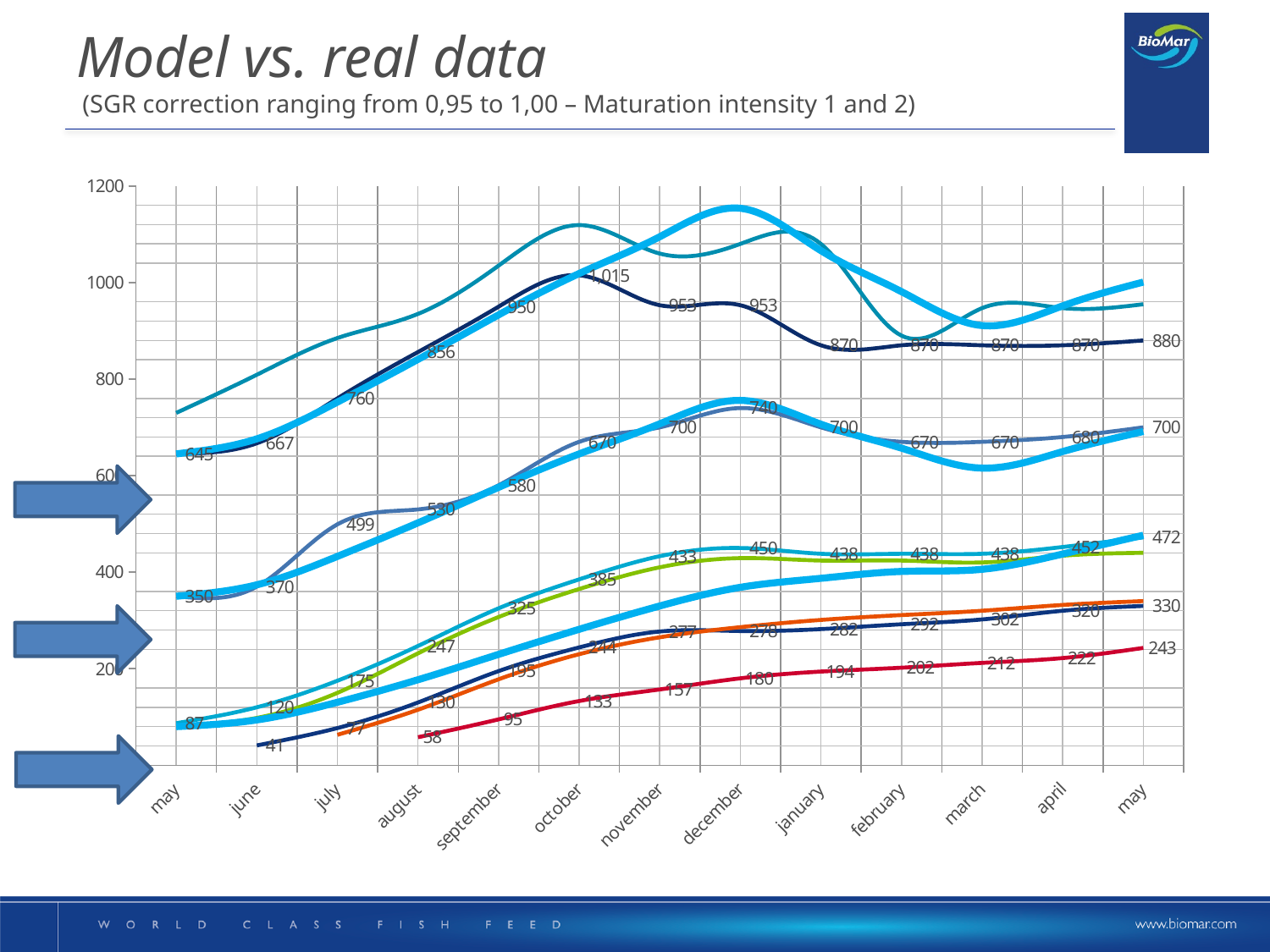
Which is larger on the red line: the value in january (194) or the value in december (180)? january (194) What value is labelled on the red line in december? 180 Is the peak of the thick light blue top line in december greater or less than 1000? greater What is the highest value labelled on the chart, reached by the dark navy line in october? 1,015 What is the lowest value labelled on the chart, shown on the lower dark navy line in june? 41 What is the title of the slide containing the chart? Model vs. real data What is the value labelled at the end of the red line in may? 243 How many month categories are shown along the x axis? 13 Does the red line rise or fall from august to may? rise What kind of chart is shown on the slide? line chart What is the difference between the red line's labelled values in may (243) and april (222)? 21 What value is labelled at the end of the upper dark navy line in may? 880